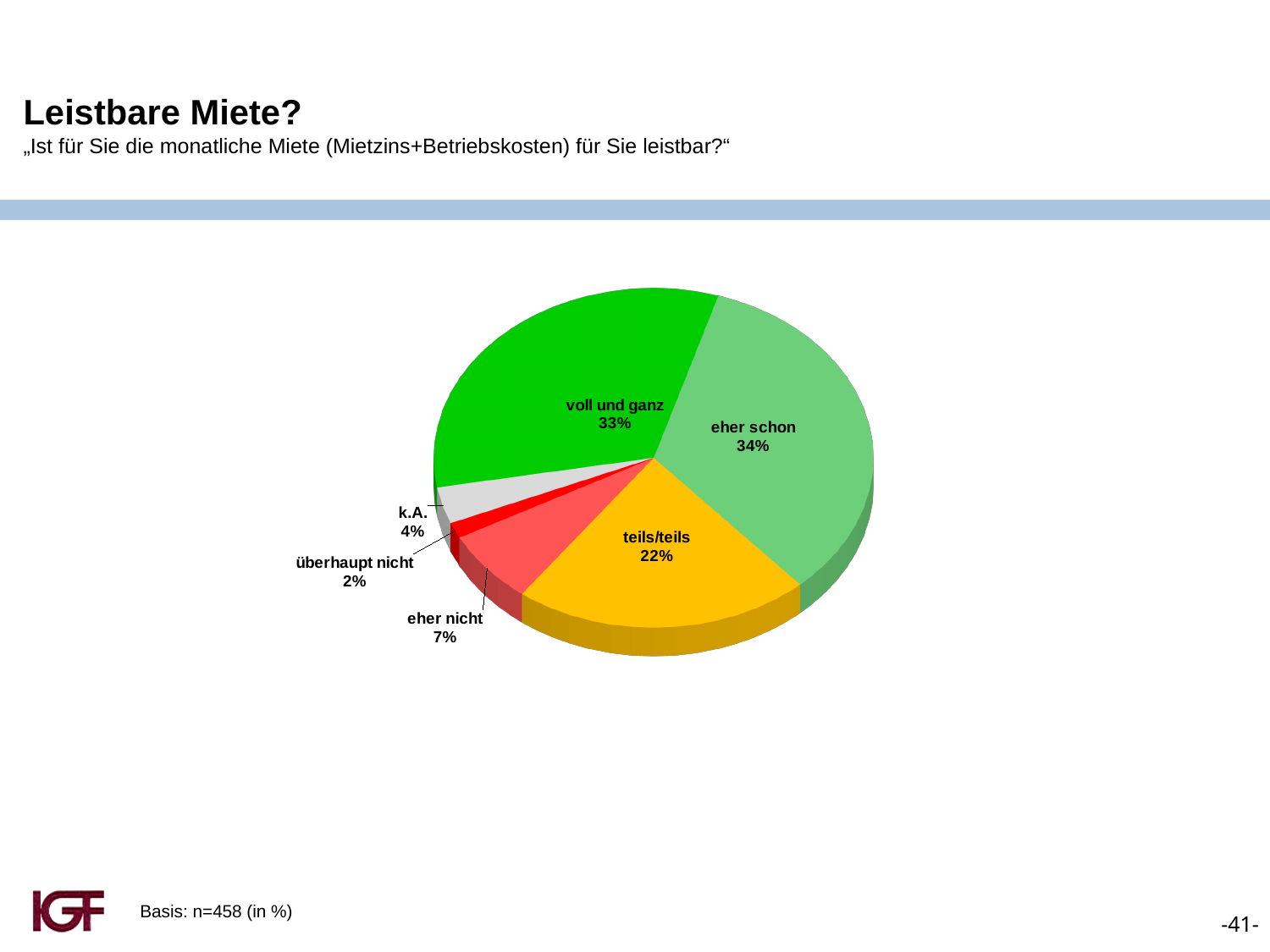
What share of the pie is labelled "eher nicht"? 7% Which category has the largest slice of the pie? eher schon What share of the pie is labelled "teils/teils"? 22% What share of the pie is labelled "überhaupt nicht"? 2% What share of the pie is labelled "voll und ganz"? 33% How many slices does the pie chart have? 6 Which is larger, the slice for "k.A." or the slice for "überhaupt nicht"? k.A. What share of the pie is labelled "k.A."? 4% What kind of chart is shown on the slide? pie chart What share of the pie is labelled "eher schon"? 34% Which category has the smallest slice of the pie? überhaupt nicht What is the difference in percentage points between "teils/teils" and "eher nicht"? 15